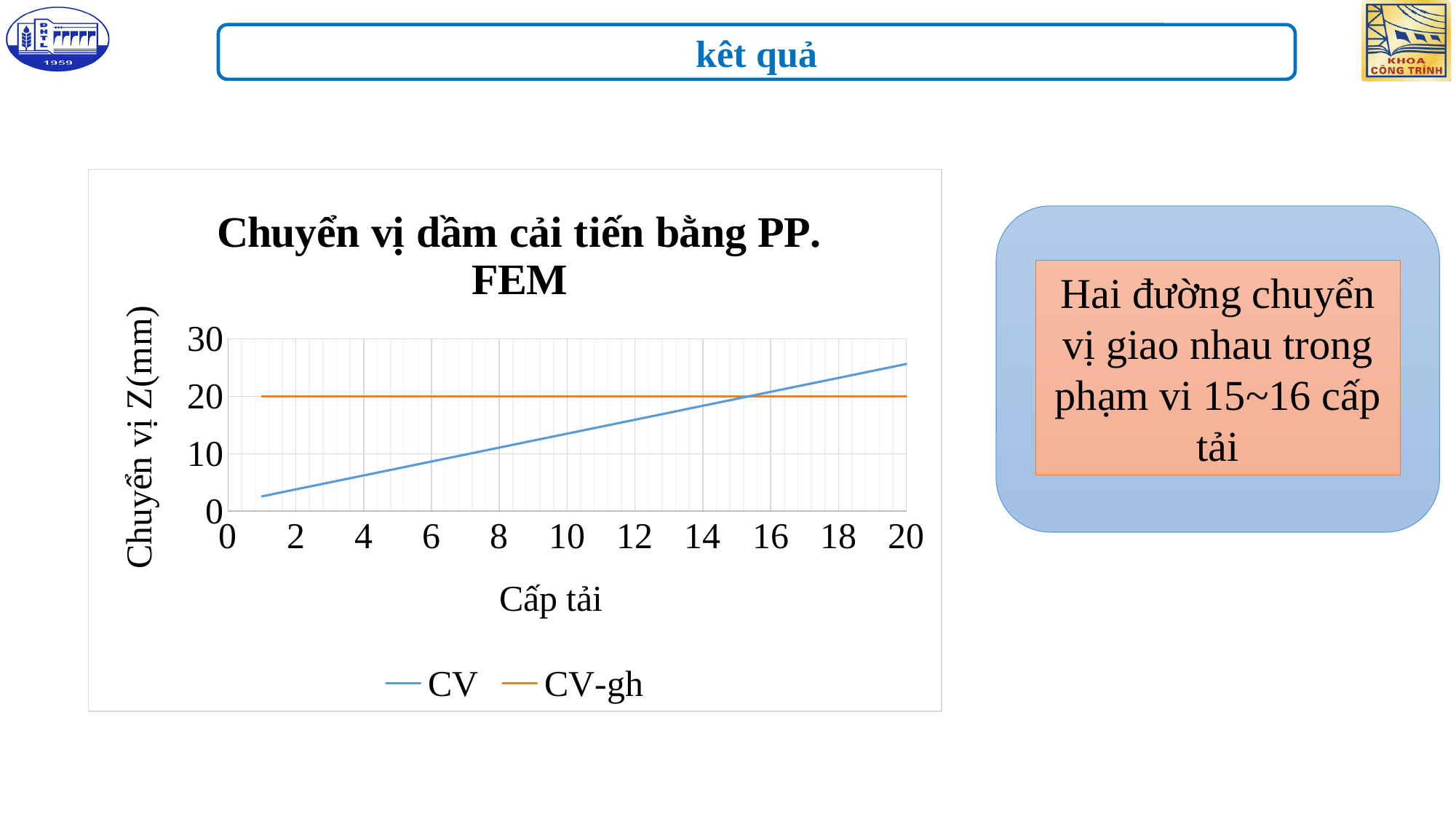
At Cấp tải 10, which series has the larger value, CV or CV-gh? CV-gh How many series does the legend of the chart list? 2 What kind of chart is shown on the slide? line chart Does the CV series rise or fall as Cấp tải increases? rise At Cấp tải 20, which series has the larger value, CV or CV-gh? CV Is the value of CV at Cấp tải 2 greater or less than 10? less Is the value of CV at Cấp tải 10 greater or less than 20? less Is the value of CV at Cấp tải 20 greater or less than 20? greater Does the CV-gh series rise, fall, or stay constant as Cấp tải increases? stay constant What are the two series named in the chart legend? CV and CV-gh What is the title of the chart? Chuyển vị dầm cải tiến bằng PP. FEM What is the value of the CV-gh series in mm? 20